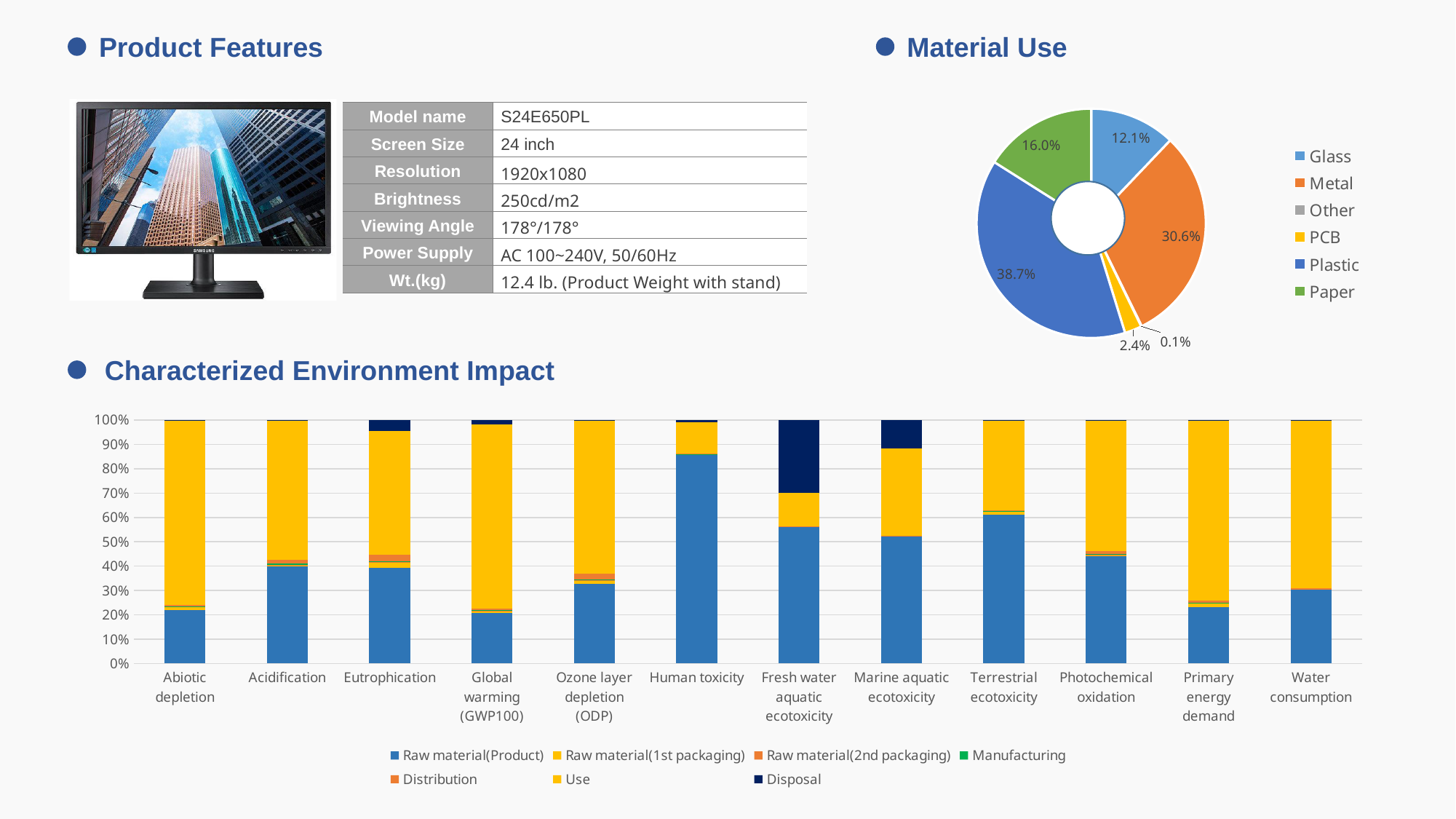
In the Material Use pie chart, what is the difference between the Plastic and Metal shares? 8.1% In the Material Use pie chart, what percentage is Metal? 30.6% In the Material Use pie chart, which material has the smallest share? Other How many categories are shown on the x axis of the Characterized Environment Impact chart? 12 What kind of chart is the Characterized Environment Impact chart? Stacked bar chart In the Material Use pie chart, which material has the largest share? Plastic In the Characterized Environment Impact chart, is the Raw material(Product) value for Human toxicity greater or less than 80%? greater In the Material Use pie chart, what percentage is Paper? 16.0% In the Characterized Environment Impact chart, which category has the largest Raw material(Product) share? Human toxicity In the Material Use pie chart, what percentage is Plastic? 38.7% How many entries does the legend of the Material Use pie chart list? 6 In the Material Use pie chart, which is larger, Glass or Paper? Paper